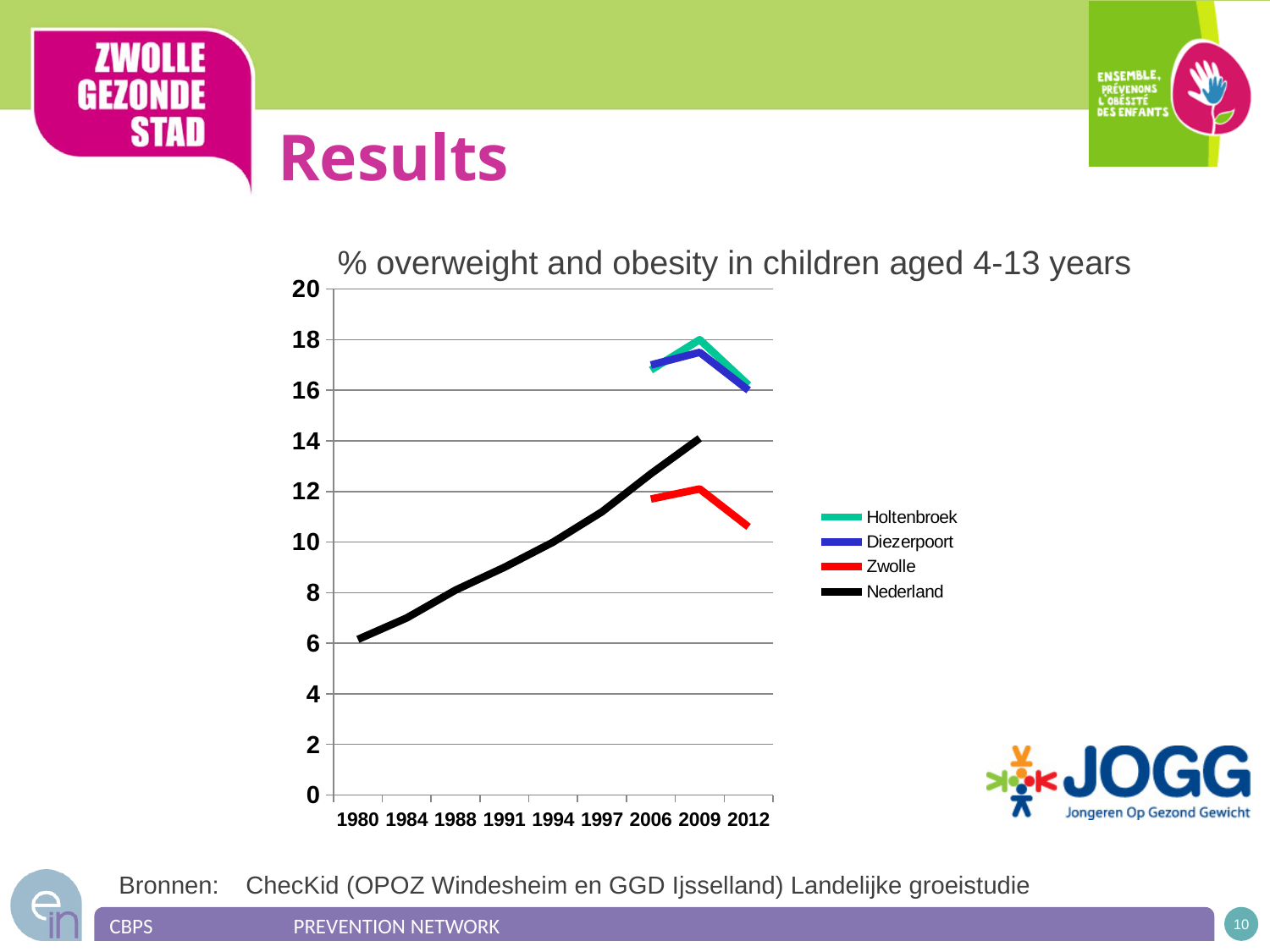
Which series has the lowest value in 2009? Zwolle What is the title of the chart? % overweight and obesity in children aged 4-13 years Which colour is used for the Nederland series? black Is the value for Holtenbroek in 2009 greater or less than 16? greater How many years are labelled on the x axis? 9 How many series does the legend list? 4 What kind of chart is shown on the slide? line chart Is the value for Nederland in 1980 greater or less than 8? less Does the Nederland series rise or fall from 1980 to 2009? rise In 2009, which is higher: Holtenbroek or Zwolle? Holtenbroek Does the Zwolle series rise or fall from 2009 to 2012? fall Is the value for Zwolle in 2012 greater or less than 12? less